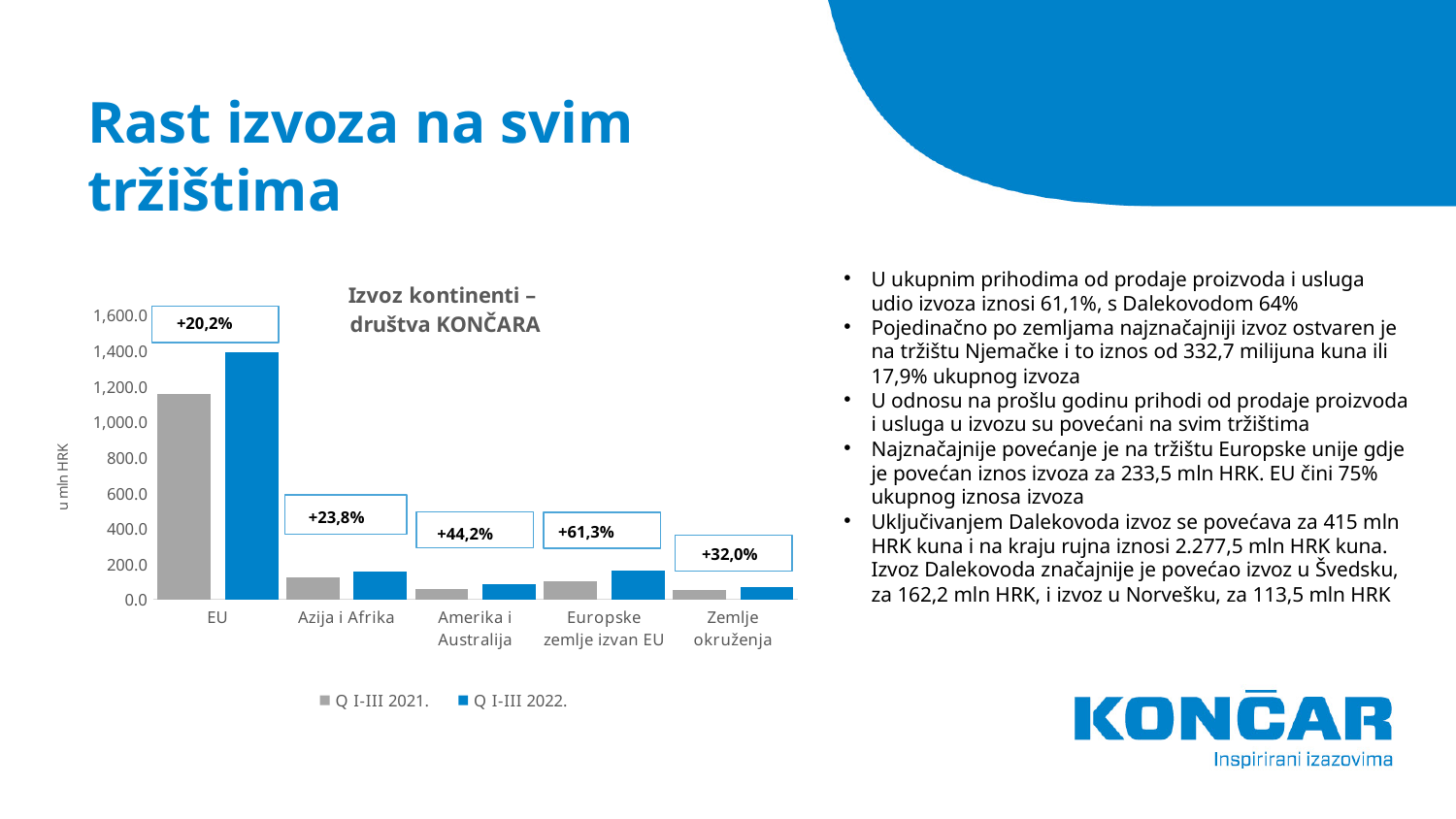
How many series does the chart legend list? 2 What is the title of the chart? Izvoz kontinenti – društva KONČARA How many categories are shown on the x axis of the chart? 5 Which category shows the smallest labelled percentage increase? EU What kind of chart is shown on the slide? bar chart Is the Q I-III 2022. value for EU greater or less than 1,200.0? greater Which category shows the largest labelled percentage increase? Europske zemlje izvan EU Is the Q I-III 2022. value for Azija i Afrika greater or less than 200.0? less What percentage change is labelled above the Europske zemlje izvan EU bars? +61,3% What percentage change is labelled above the Zemlje okruženja bars? +32,0% What percentage change is labelled above the EU bars? +20,2% Which category has the highest export value for Q I-III 2022.? EU